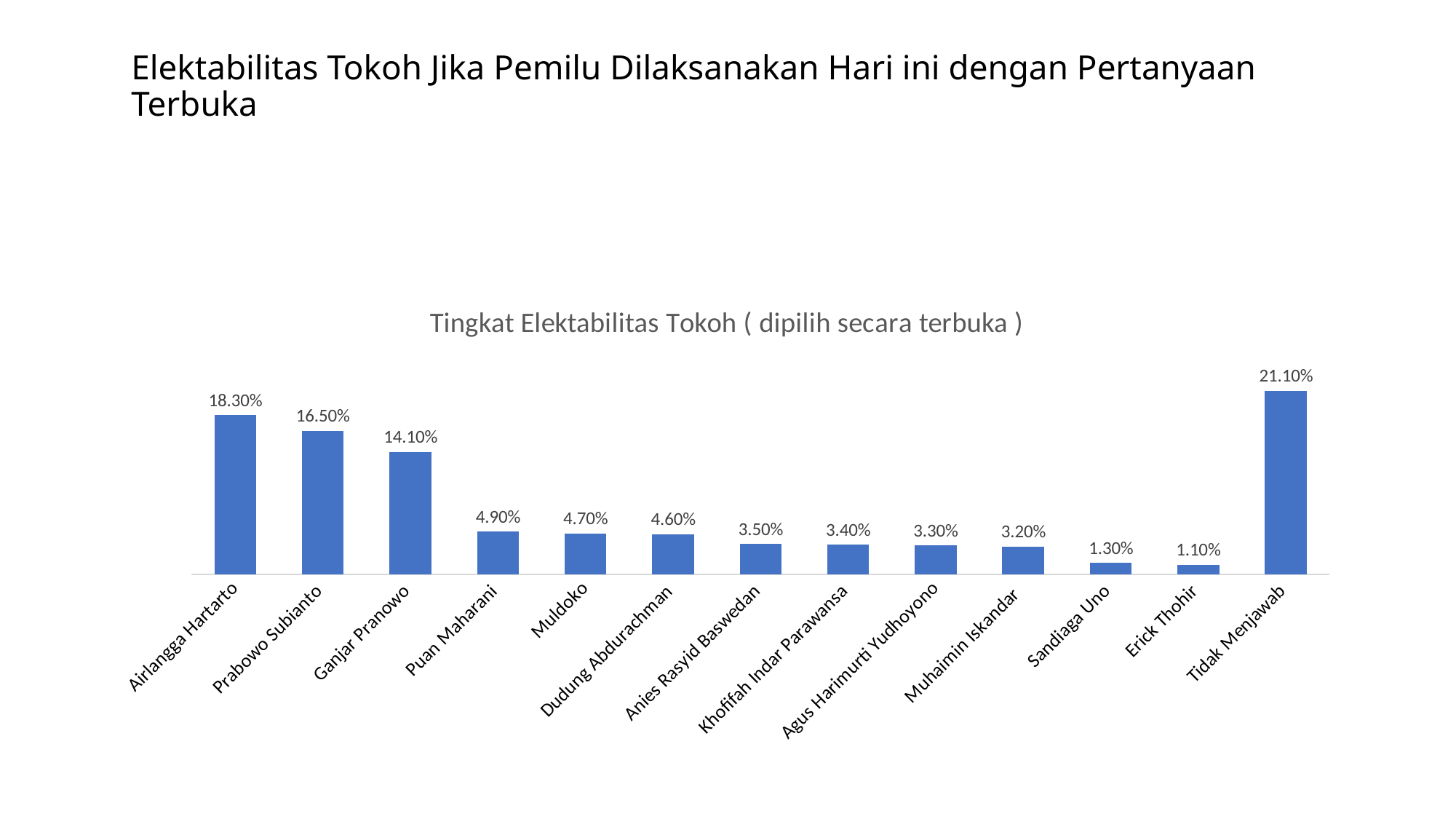
What is the difference between the values for Airlangga Hartarto and Prabowo Subianto? 1.80% Which category has the highest value? Tidak Menjawab What is the value for Airlangga Hartarto? 18.30% How many categories are shown on the x axis? 13 What is the value for Ganjar Pranowo? 14.10% What is the value for Erick Thohir? 1.10% Which is larger, the value for Puan Maharani or the value for Muldoko? Puan Maharani What is the chart's title? Tingkat Elektabilitas Tokoh ( dipilih secara terbuka ) What is the value for Sandiaga Uno? 1.30% Which category has the lowest value? Erick Thohir What kind of chart is this? Bar chart What is the difference between the values for Tidak Menjawab and Airlangga Hartarto? 2.80%